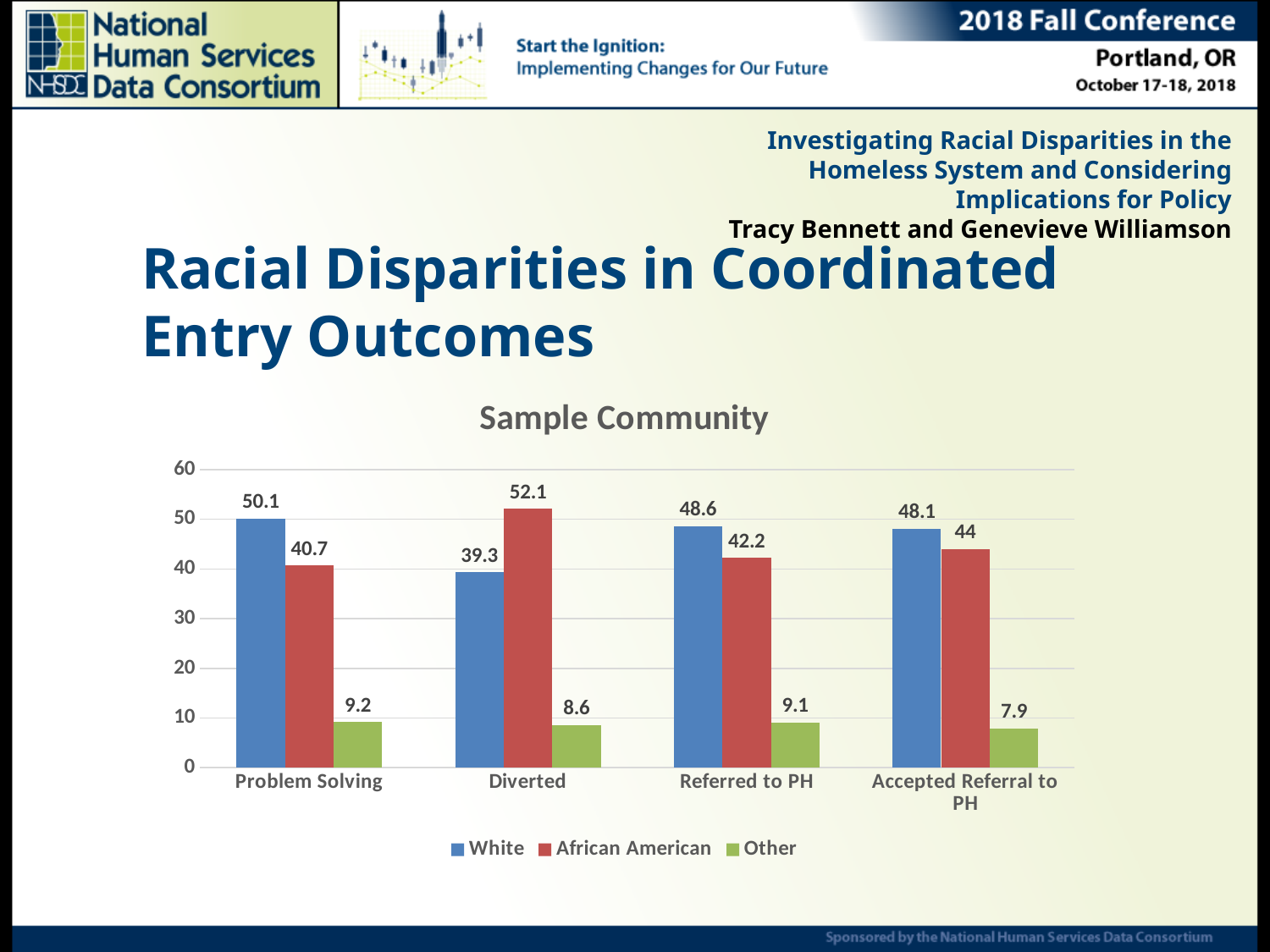
How many series does the legend list? 3 Which is larger in the Referred to PH category, the White value or the African American value? White What is the difference between the White and African American values in the Problem Solving category? 9.4 What is the value for African American in the Diverted category? 52.1 In which category is the African American value highest? Diverted What kind of chart is shown on the slide? Bar chart What is the value for Other in the Accepted Referral to PH category? 7.9 How many categories are shown on the x axis? 4 In which category is the White value lowest? Diverted What is the title of the chart? Sample Community What is the difference between the African American values for Diverted and Problem Solving? 11.4 What is the value for White in the Problem Solving category? 50.1